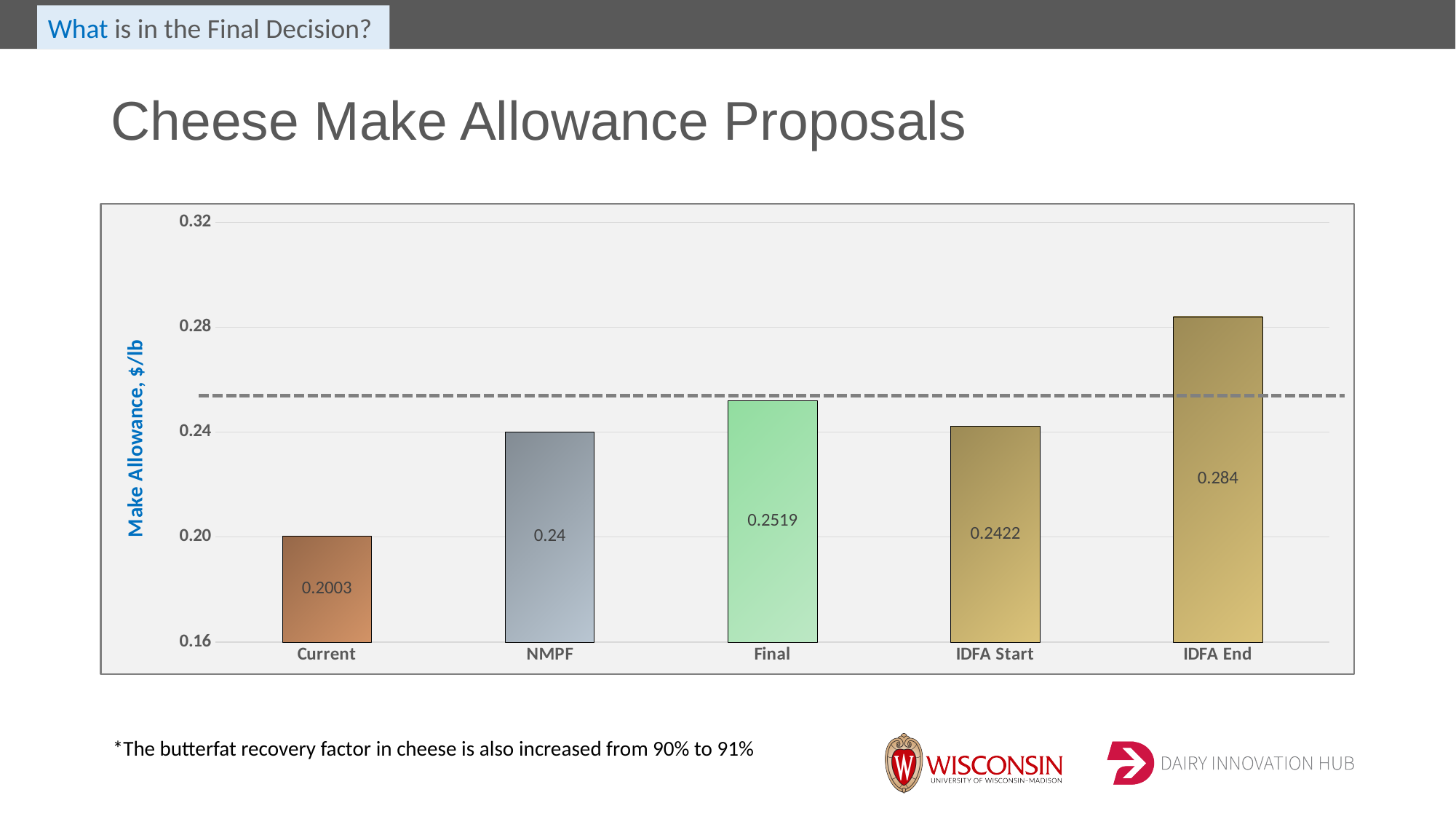
What is the difference between the IDFA End value and the Current value? 0.0837 What is the make allowance value for the Final category? 0.2519 Which category has the highest make allowance? IDFA End What kind of chart is shown on the slide? bar chart How many categories are shown on the x axis? 5 Is the value for IDFA End greater or less than 0.28? greater What is the label of the y axis? Make Allowance, $/lb What is the difference between the Final value and the NMPF value? 0.0119 Which is larger, the value for Final or the value for IDFA Start? Final What is the make allowance value for the Current category? 0.2003 Which category has the lowest make allowance? Current What is the make allowance value for IDFA Start? 0.2422